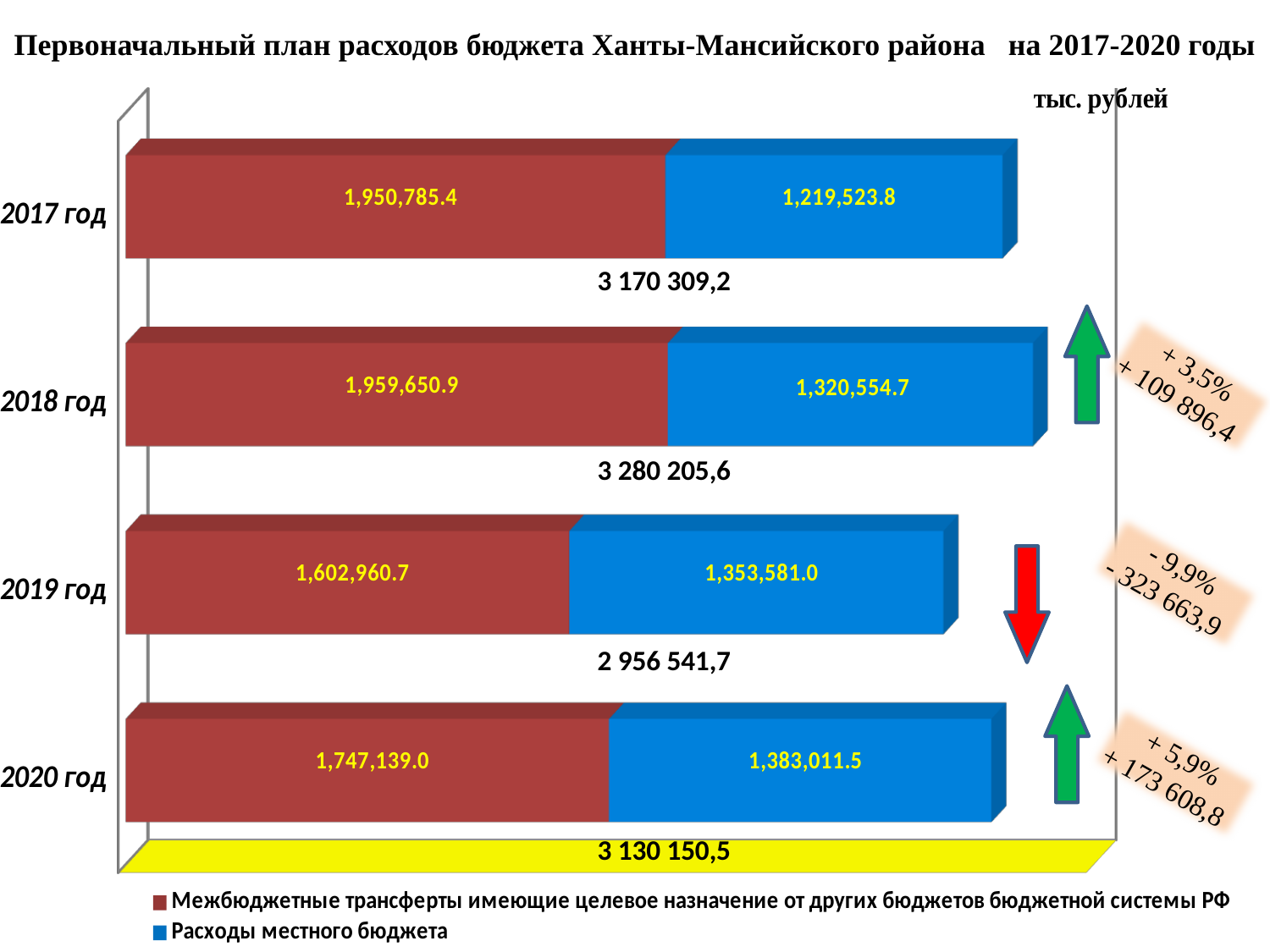
How many series does the legend list? 2 What is the value of Расходы местного бюджета for 2020 год? 1,383,011.5 Does the value of Расходы местного бюджета rise or fall from 2017 год to 2020 год? rise How many years are shown in the chart? 4 What is the value of Расходы местного бюджета for 2019 год? 1,353,581.0 What is the value of Межбюджетные трансферты for 2017 год? 1,950,785.4 What is the total of the stacked bar for 2018 год? 3 280 205,6 Which year has the highest value for Межбюджетные трансферты? 2018 год Which year has the lowest value for Межбюджетные трансферты? 2019 год Which is larger in 2019 год: Межбюджетные трансферты or Расходы местного бюджета? Межбюджетные трансферты Which year has the lowest value for Расходы местного бюджета? 2017 год What is the difference between Межбюджетные трансферты and Расходы местного бюджета in 2017 год? 731,261.6